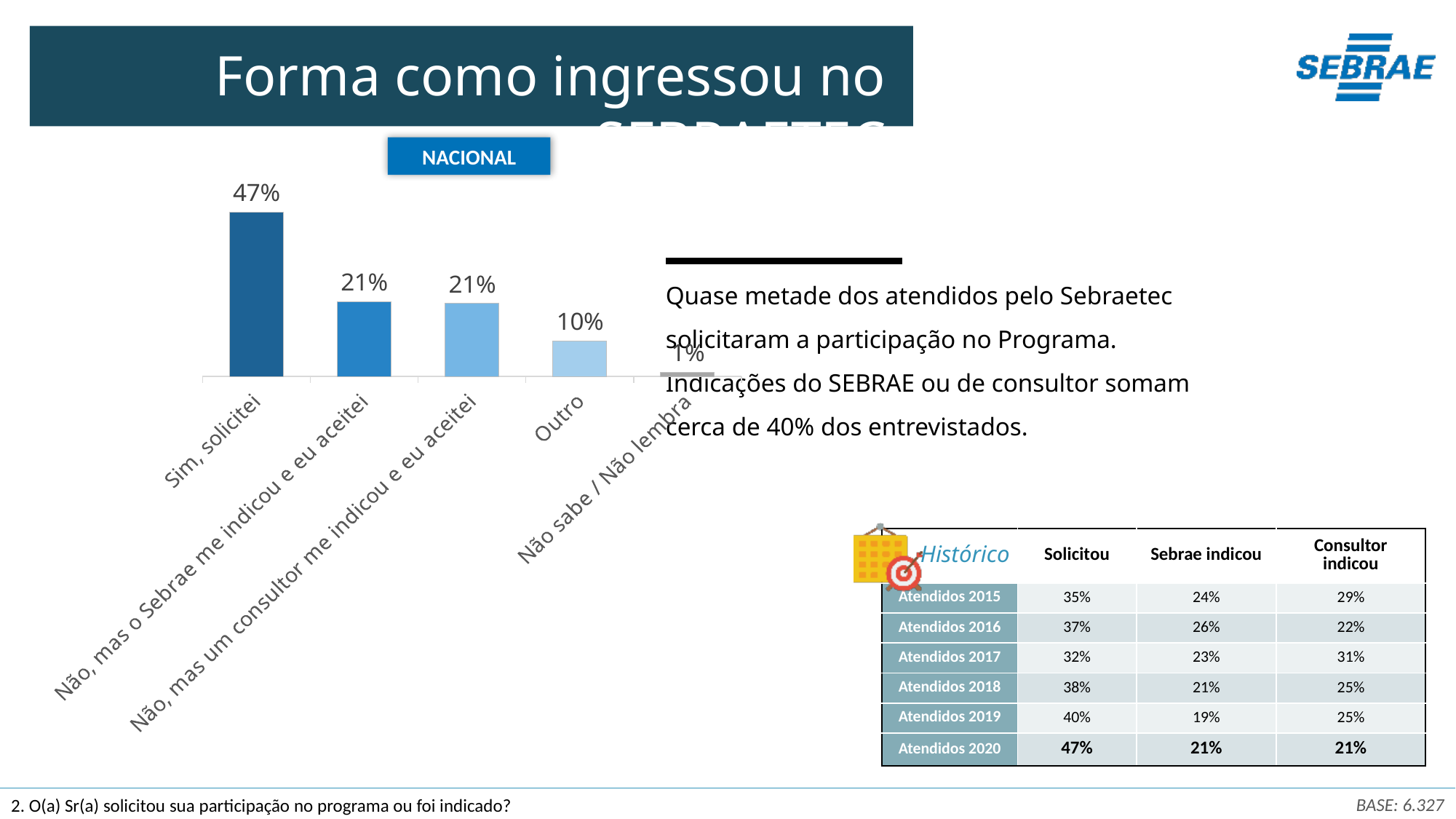
What label appears in the blue box above the chart? NACIONAL What is the value for "Outro"? 10% What is the value for "Sim, solicitei"? 47% Which category has the lowest value? Não sabe / Não lembra What is the difference between the values for "Sim, solicitei" and "Outro"? 37% What is the value for "Não, mas o Sebrae me indicou e eu aceitei"? 21% Which is larger, the value for "Outro" or the value for "Não, mas um consultor me indicou e eu aceitei"? Não, mas um consultor me indicou e eu aceitei What is the value for "Não sabe / Não lembra"? 1% Which category has the highest value? Sim, solicitei Do the values rise or fall from left to right along the x axis? fall What kind of chart is shown on the slide? bar chart How many categories are plotted in the bar chart? 5